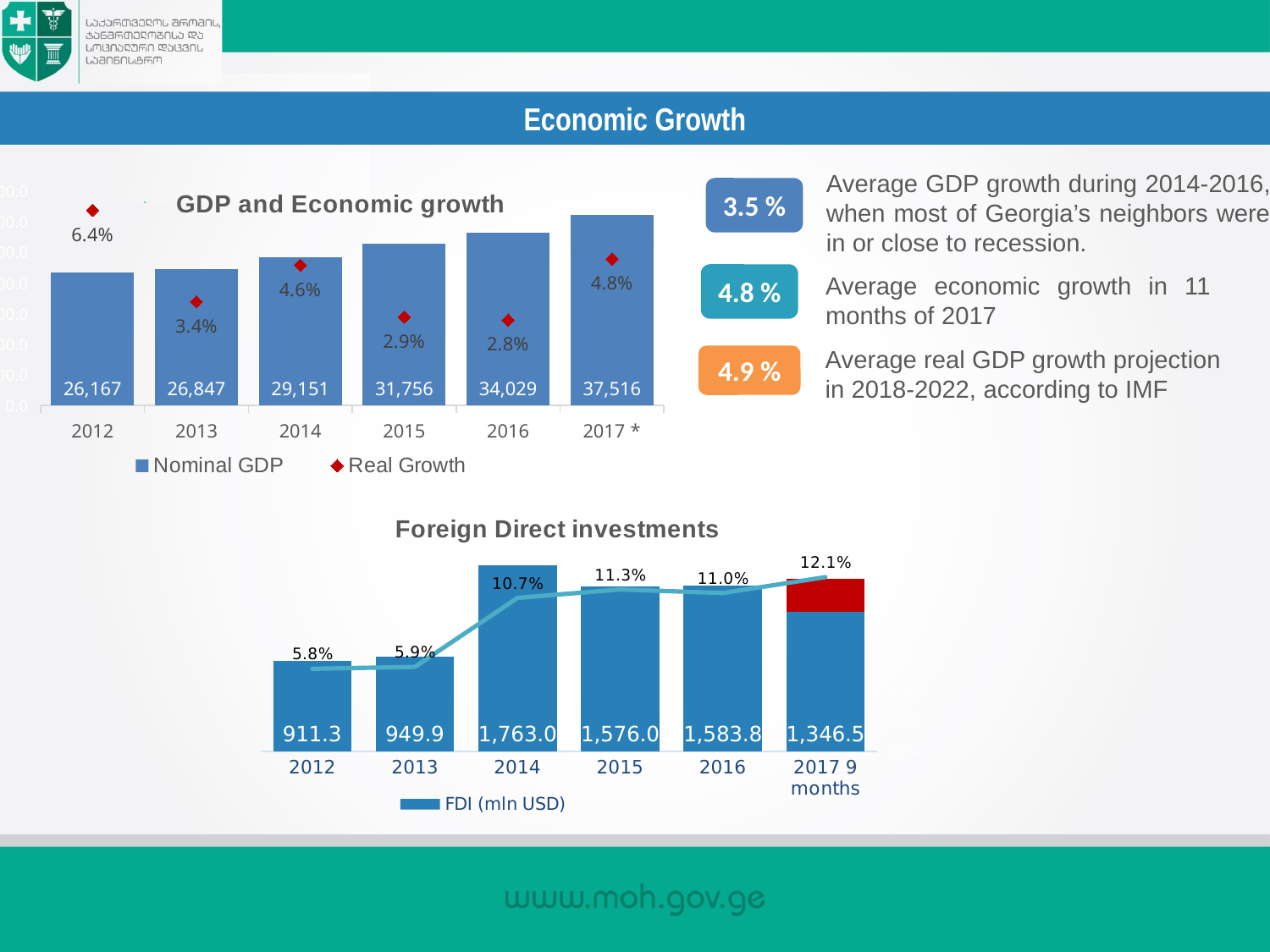
In the 'GDP and Economic growth' chart, how many series does the legend list? 2 In the 'Foreign Direct investments' chart, which year has the highest FDI value? 2014 In the 'GDP and Economic growth' chart, which year has the lowest Nominal GDP? 2012 In the 'GDP and Economic growth' chart, what is the difference in Nominal GDP between 2017 * and 2016? 3,487 In the 'Foreign Direct investments' chart, how many years are shown on the x axis? 6 In the 'Foreign Direct investments' chart, is the FDI value for 2016 larger than the value for 2015? Yes In the 'GDP and Economic growth' chart, what is the Nominal GDP value for 2014? 29,151 In the 'GDP and Economic growth' chart, what is the Real Growth value for 2015? 2.9% In the 'GDP and Economic growth' chart, do the Nominal GDP values rise or fall from 2012 to 2017 *? rise In the 'Foreign Direct investments' chart, what is the FDI value for 2014? 1,763.0 In the 'GDP and Economic growth' chart, which year has the highest Real Growth? 2012 In the 'Foreign Direct investments' chart, what is the difference between the FDI values for 2013 and 2012? 38.6